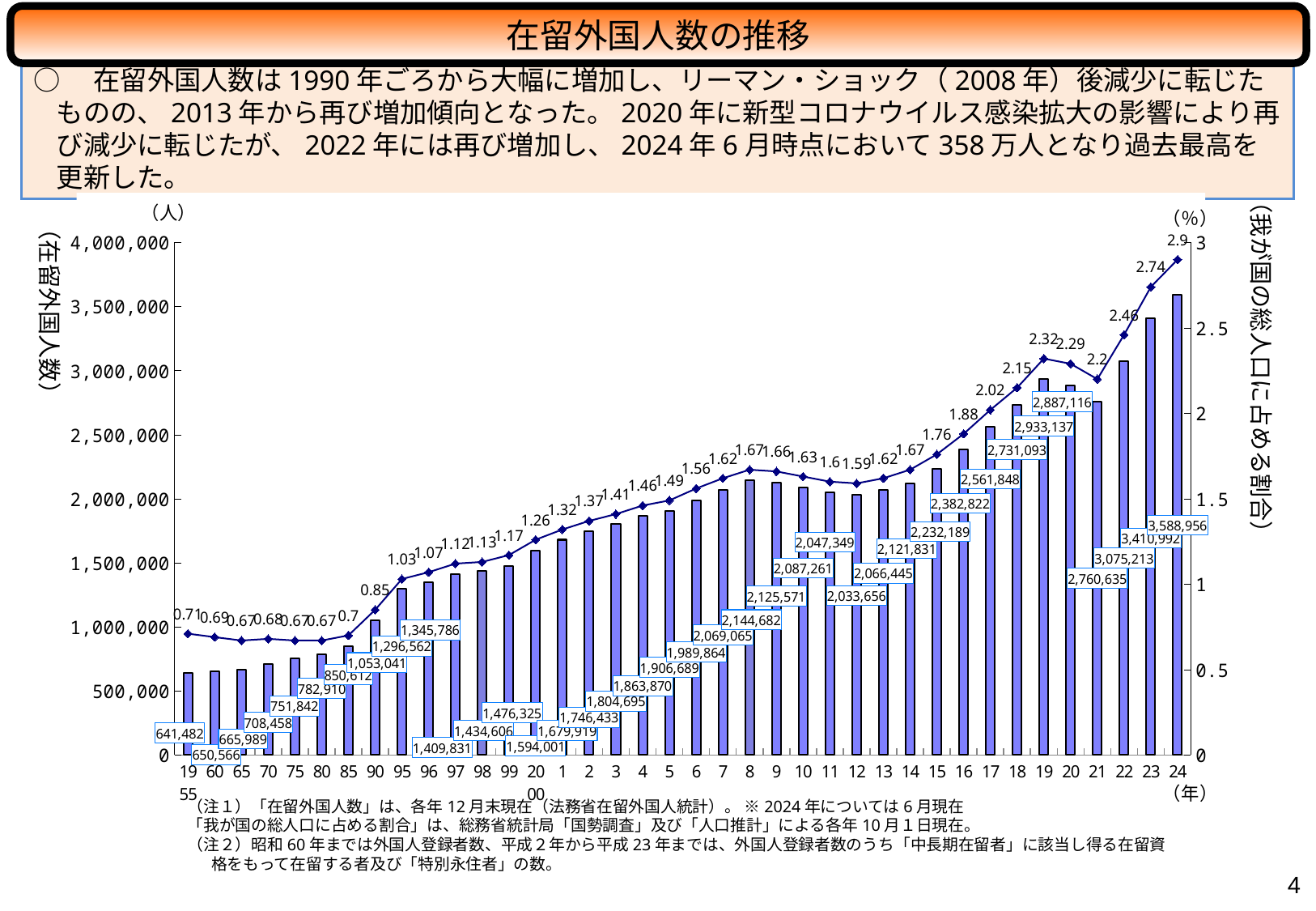
What is the number of foreign residents (在留外国人数) shown for 2024? 3,588,956 Does the number of foreign residents rise or fall from 2008 to 2012? fall Which year has more foreign residents, 2019 or 2020? 2019 What is the number of foreign residents shown for 1990? 1,053,041 Is the number of foreign residents in 2022 greater or less than 3,000,000? greater What share of Japan's total population (%) is shown for 2024? 2.9 What kind of chart is shown on the slide? Combined bar and line chart What unit is shown on the right-hand vertical axis? (%) Which year has the highest number of foreign residents? 2024 Which year has the lowest number of foreign residents? 1955 (641,482) What is the difference between the number of foreign residents in 2024 and in 2023? 177,964 What share of the total population is shown for 2008? 1.67